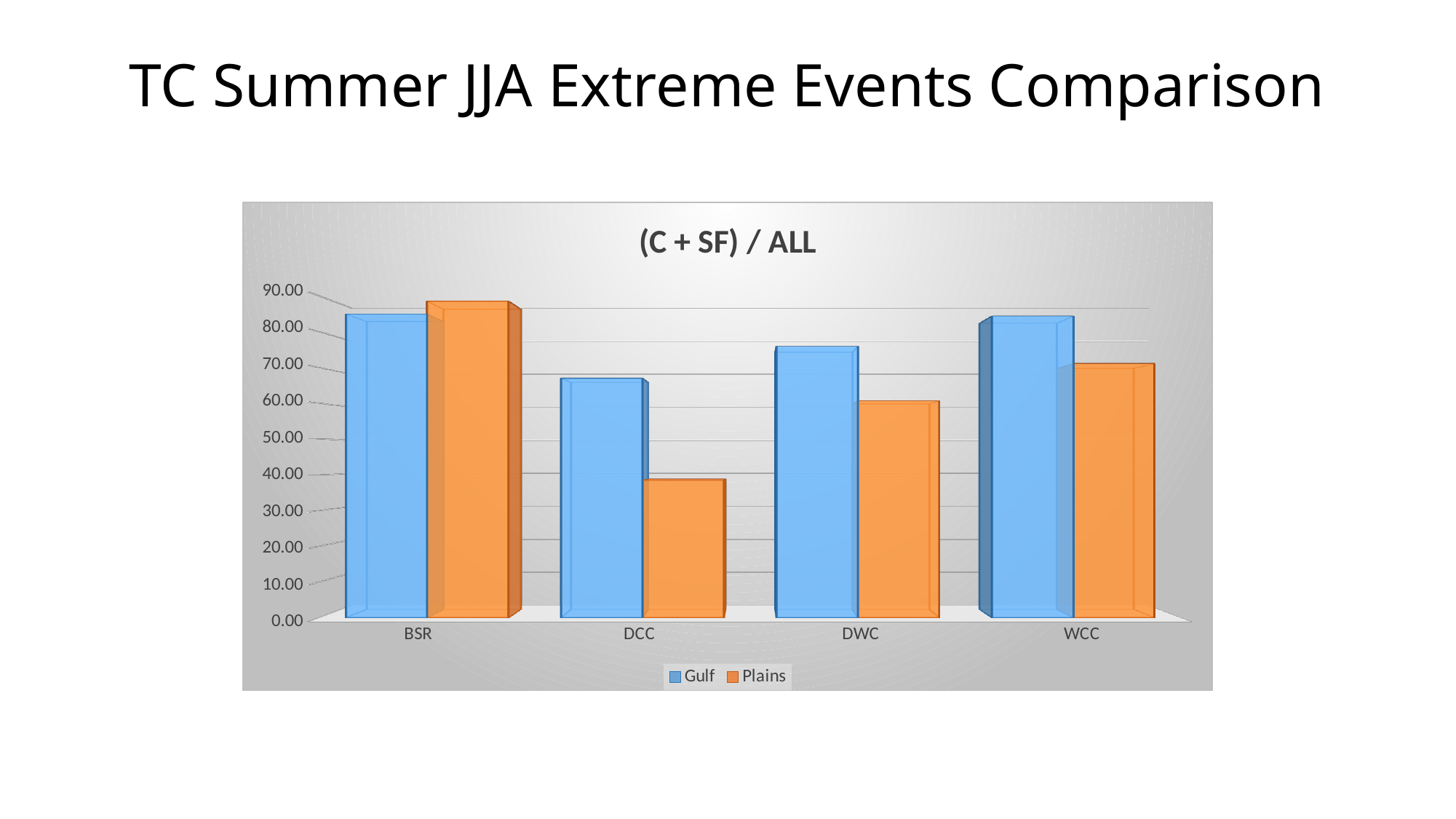
What kind of chart is shown on the slide? bar chart How many series does the chart's legend list? 2 Which category has the lowest Gulf value? DCC For DCC, which series has the larger value, Gulf or Plains? Gulf Is the Plains value for DCC greater or less than 50.00? less For DWC, which series has the larger value, Gulf or Plains? Gulf Is the Plains value for BSR greater or less than 80.00? greater Which category has the highest Plains value? BSR Which category has the lowest Plains value? DCC What is the title of the chart? (C + SF) / ALL How many categories are shown on the x axis of the chart? 4 Which series is shown in orange in the chart? Plains